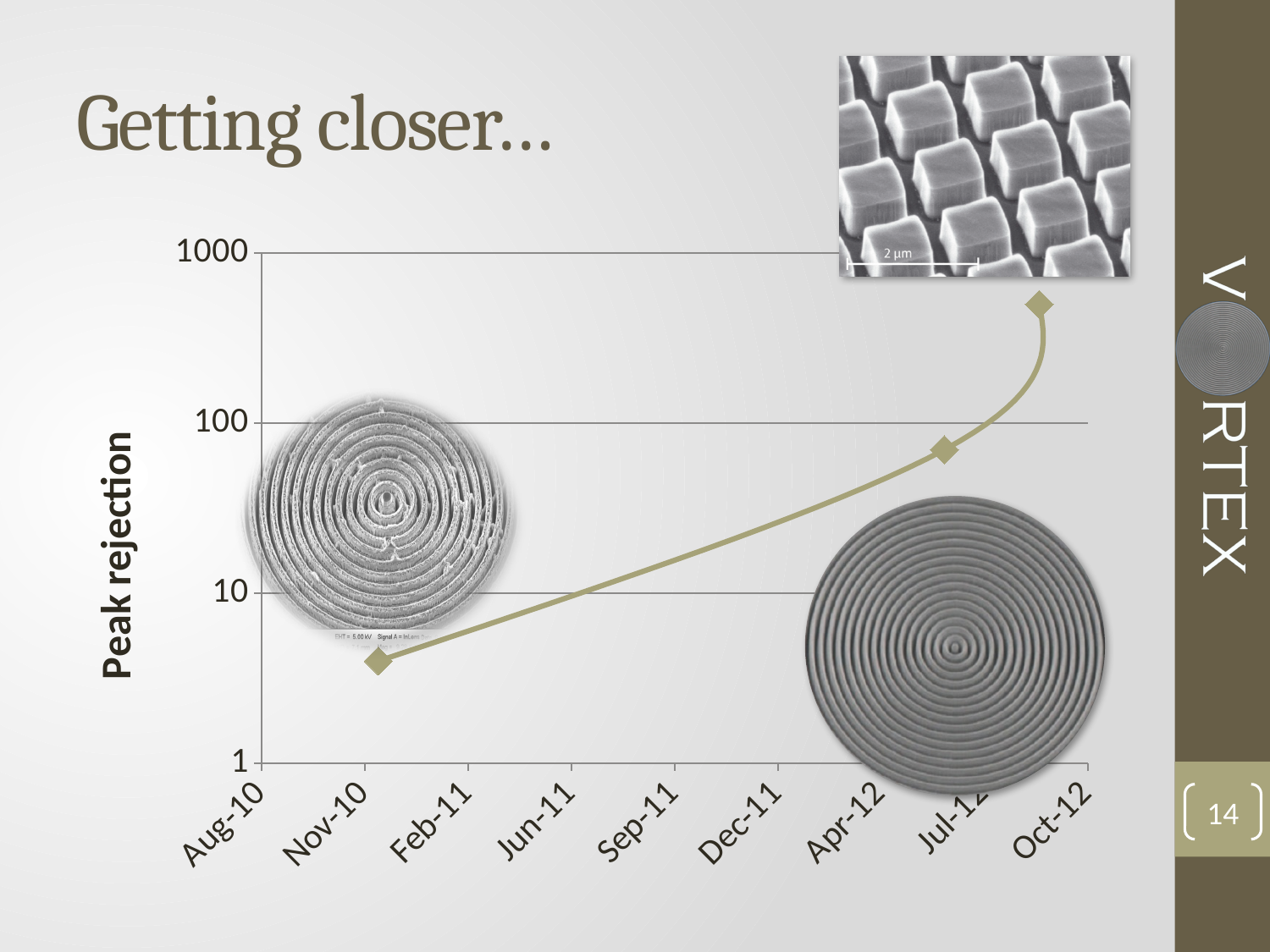
Which is larger, the value of the middle data point or the value of the first data point? middle data point Which data point has the lowest peak rejection: the first, middle, or last? first Do the plotted values rise or fall from left to right along the x axis? rise What kind of chart is shown on the slide? line chart Which data point has the highest peak rejection: the first, middle, or last? last Is the value of the last (rightmost) data point greater or less than 100? greater Is the value of the middle data point greater or less than 100? less What is the highest tick value shown on the vertical axis? 1000 Is the value of the first (leftmost) data point greater or less than 10? less What is the label of the vertical axis? Peak rejection How many data points are plotted on the line? 3